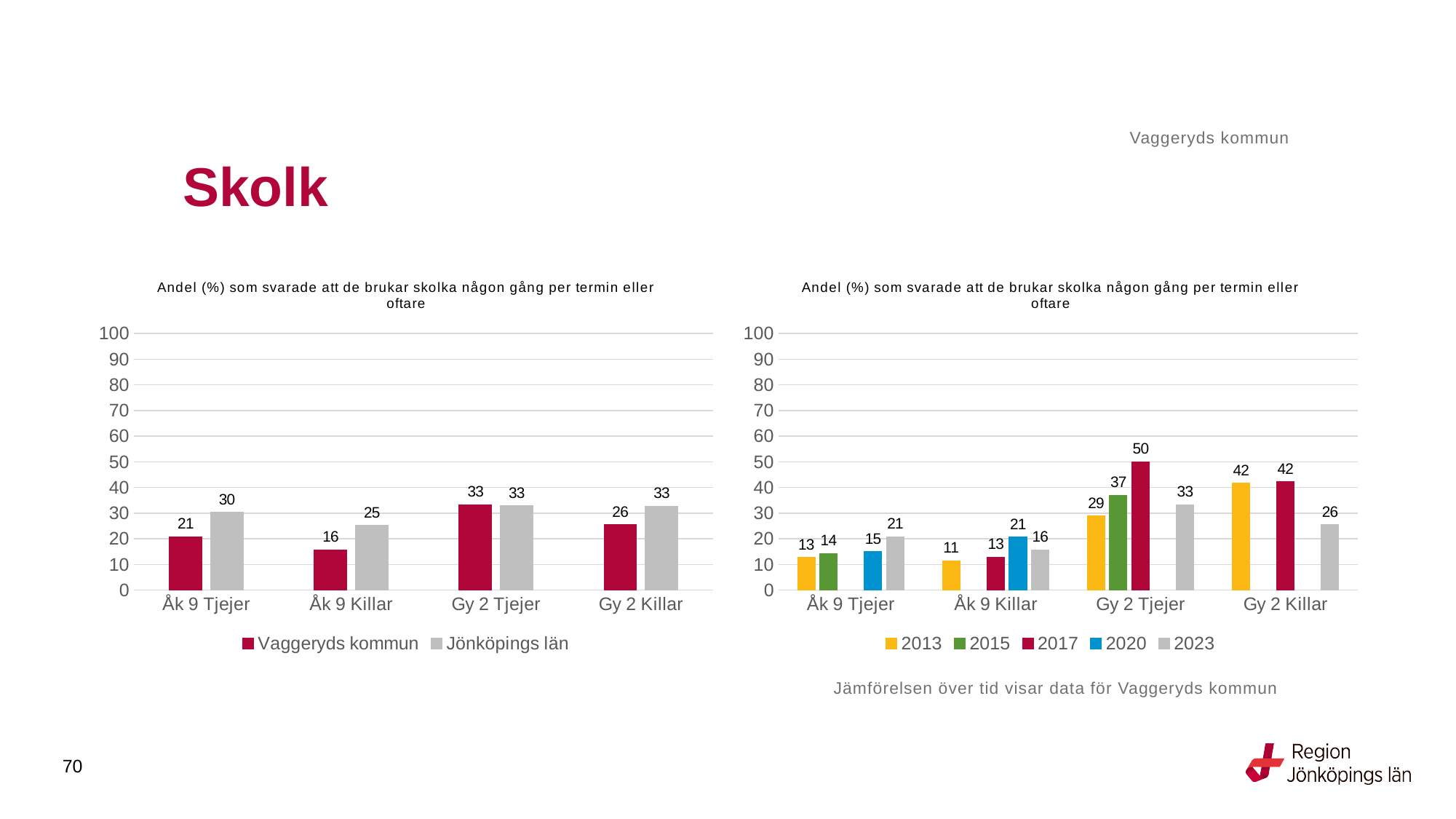
In the left chart, what is the value for Jönköpings län for Gy 2 Killar? 33 What type of chart is the left chart? Bar chart In the right chart, which is larger for Gy 2 Killar: the value for 2013 or the value for 2023? 2013 In the right chart, what is the difference between the 2013 and 2023 values for Gy 2 Killar? 16 In the left chart, how many series does the legend list? 2 In the right chart, what is the value for 2017 for Gy 2 Tjejer? 50 In the left chart, which category has the lowest value for Vaggeryds kommun? Åk 9 Killar In the left chart, what is the value for Vaggeryds kommun for Åk 9 Killar? 16 In the right chart, which year has the highest value for Gy 2 Tjejer? 2017 In the right chart, what is the value for 2020 for Åk 9 Killar? 21 In the right chart, how many series does the legend list? 5 In the left chart, what is the difference between Jönköpings län and Vaggeryds kommun for Åk 9 Tjejer? 9